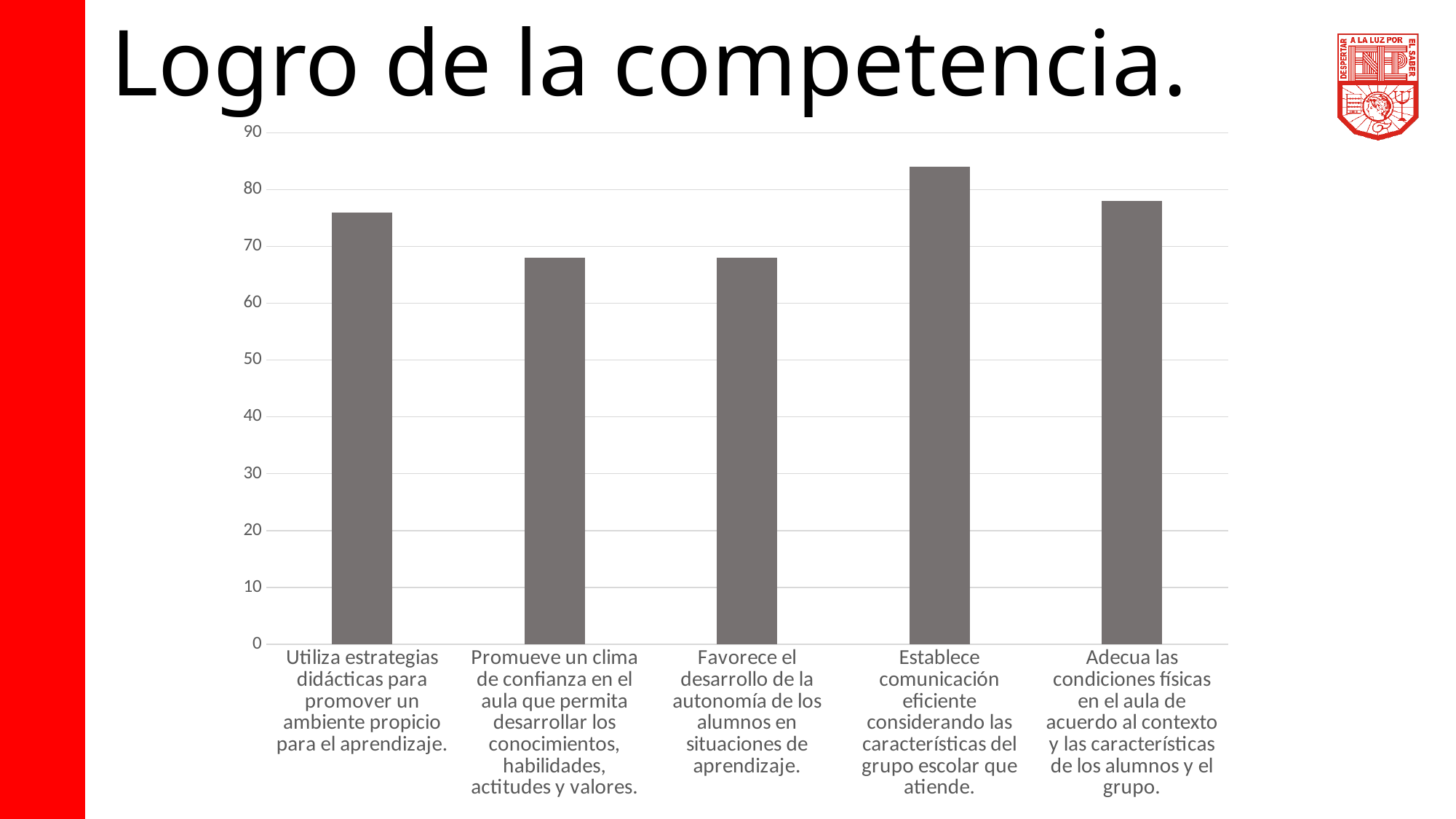
What is the title of the slide containing the chart? Logro de la competencia. Which is larger: the value for 'Utiliza estrategias didácticas para promover un ambiente propicio para el aprendizaje.' or for 'Promueve un clima de confianza en el aula que permita desarrollar los conocimientos, habilidades, actitudes y valores.'? Utiliza estrategias didácticas para promover un ambiente propicio para el aprendizaje. Is the value for 'Promueve un clima de confianza en el aula que permita desarrollar los conocimientos, habilidades, actitudes y valores.' greater or less than 70? less Is the value for 'Establece comunicación eficiente considerando las características del grupo escolar que atiende.' greater or less than 80? greater Which is larger: the value for 'Establece comunicación eficiente considerando las características del grupo escolar que atiende.' or for 'Adecua las condiciones físicas en el aula de acuerdo al contexto y las características de los alumnos y el grupo.'? Establece comunicación eficiente considerando las características del grupo escolar que atiende. What is the maximum value shown on the vertical axis of the chart? 90 Which category has the highest bar? Establece comunicación eficiente considerando las características del grupo escolar que atiende. Is the value for 'Adecua las condiciones físicas en el aula de acuerdo al contexto y las características de los alumnos y el grupo.' greater or less than 70? greater What kind of chart is shown on the slide? bar chart How many categories (bars) does the chart show? 5